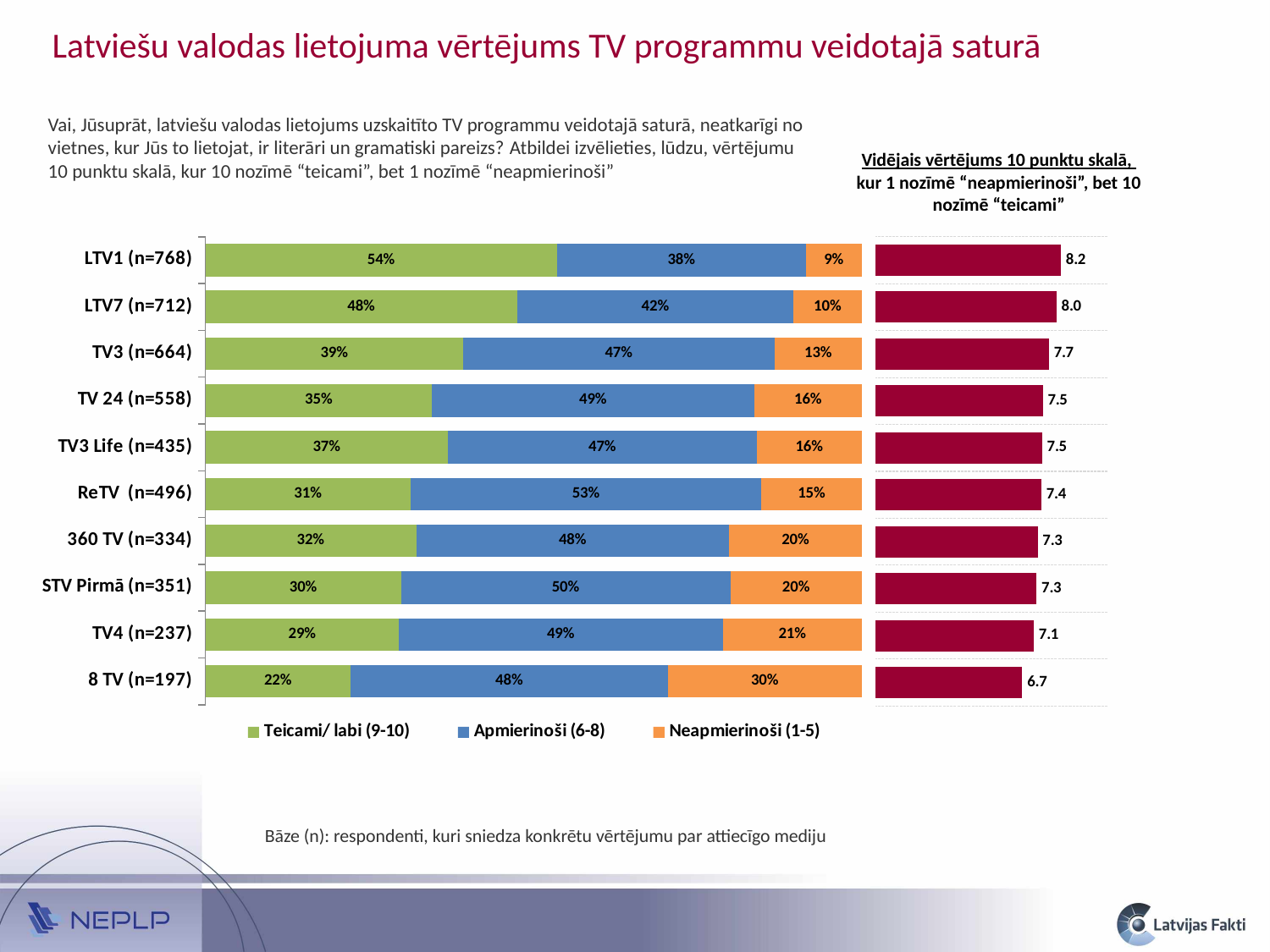
In the stacked bar chart on the left, what is the total of the three segments for LTV7 (n=712)? 100% In the average rating chart on the right (Vidējais vērtējums 10 punktu skalā), what is the average rating for TV3 (n=664)? 7.7 In the average rating chart on the right, which channel has the lowest average rating? 8 TV (n=197) In the average rating chart on the right, which channel has the highest average rating? LTV1 (n=768) In the average rating chart on the right, what is the difference between the average rating of LTV1 (n=768) and 8 TV (n=197)? 1.5 In the stacked bar chart on the left, what is the Apmierinoši (6-8) share for ReTV (n=496)? 53% In the stacked bar chart on the left, which has a larger Teicami/ labi (9-10) share: LTV7 (n=712) or TV3 (n=664)? LTV7 (n=712) How many series does the legend of the stacked bar chart on the left list? 3 How many TV channels are shown in the stacked bar chart on the left? 10 In the stacked bar chart on the left, which channel has the largest Neapmierinoši (1-5) share? 8 TV (n=197) What type of chart is the chart on the right showing the average ratings? Bar chart In the stacked bar chart on the left, what percentage of LTV1 (n=768) respondents gave a rating of Teicami/ labi (9-10)? 54%